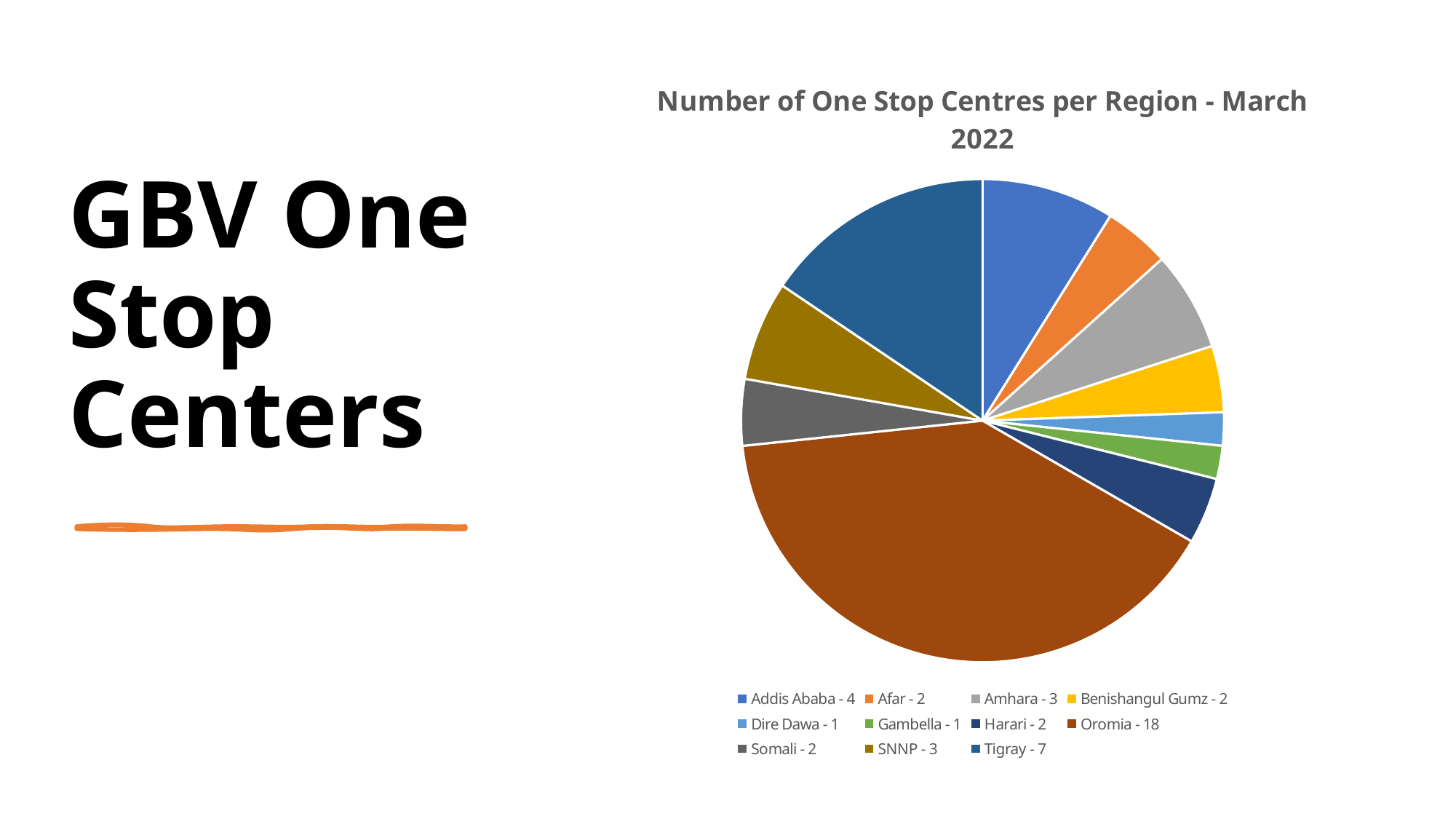
What type of chart is shown on the slide? Pie chart Which region has the highest number of One Stop Centres? Oromia What is the title of the chart? Number of One Stop Centres per Region - March 2022 What is the total number of One Stop Centres across all regions in the chart? 45 What is the difference between the number of One Stop Centres in Oromia and Tigray? 11 Which has more One Stop Centres, Amhara or Addis Ababa? Addis Ababa How many One Stop Centres does Tigray have? 7 How many One Stop Centres does Addis Ababa have? 4 How many One Stop Centres does Oromia have? 18 How many regions are shown in the pie chart? 11 Which colour represents Oromia in the pie chart? Brown What share of all One Stop Centres does Oromia account for? 40%